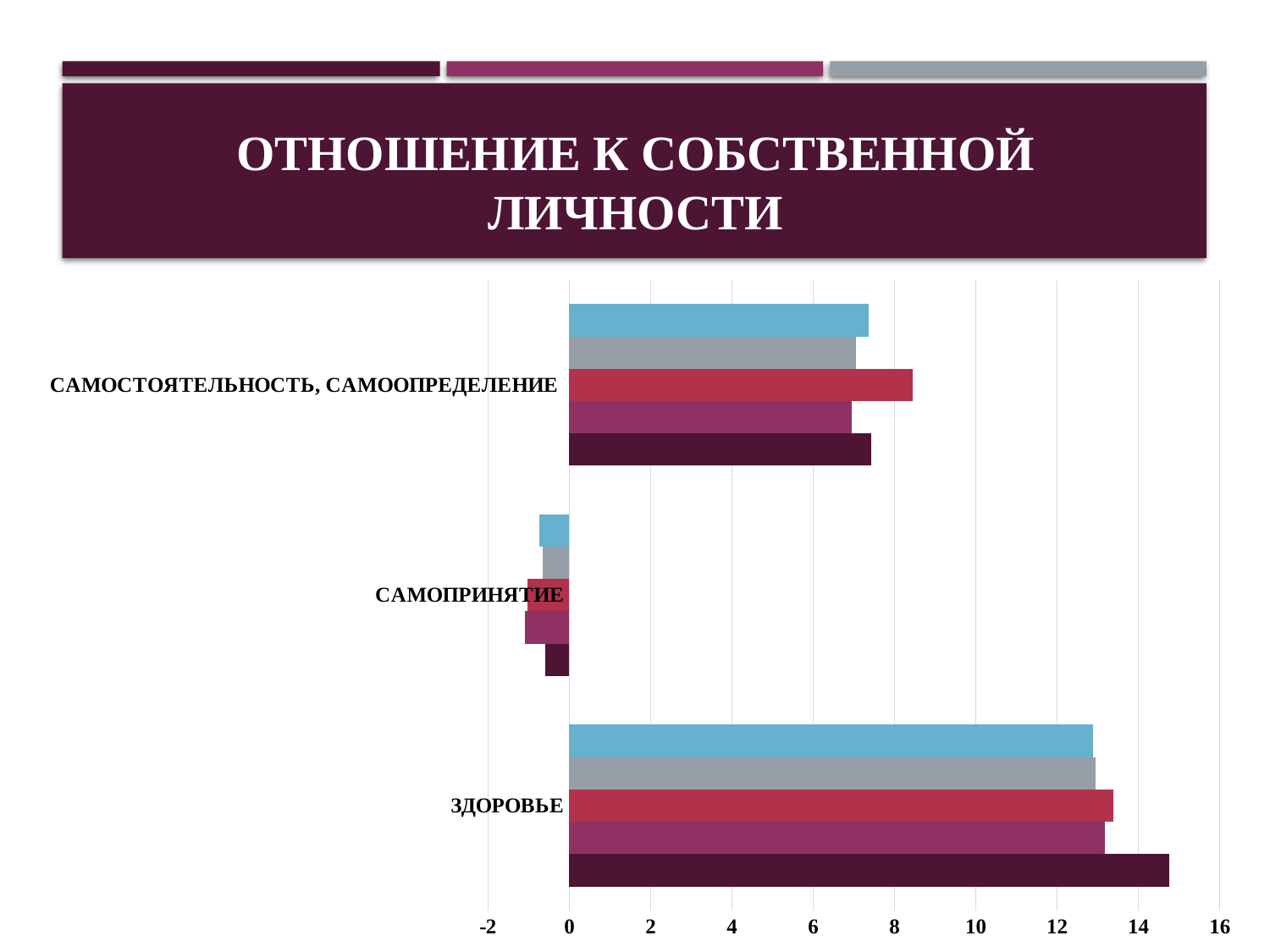
How many bars are plotted for each category on the chart? 5 What kind of chart is shown on the slide? bar chart Is the topmost (blue) bar for САМОСТОЯТЕЛЬНОСТЬ, САМООПРЕДЕЛЕНИЕ greater or less than 8? less Are the values for САМОПРИНЯТИЕ greater or less than 0? less Which category has the highest values on the chart? ЗДОРОВЬЕ Which category has larger values, ЗДОРОВЬЕ or САМОСТОЯТЕЛЬНОСТЬ, САМООПРЕДЕЛЕНИЕ? ЗДОРОВЬЕ Is the longest bar for САМОСТОЯТЕЛЬНОСТЬ, САМООПРЕДЕЛЕНИЕ greater or less than 8? greater What is the maximum value shown on the horizontal axis of the chart? 16 What is the title of the slide containing the chart? ОТНОШЕНИЕ К СОБСТВЕННОЙ ЛИЧНОСТИ Which category has the lowest values on the chart? САМОПРИНЯТИЕ How many categories are shown on the chart? 3